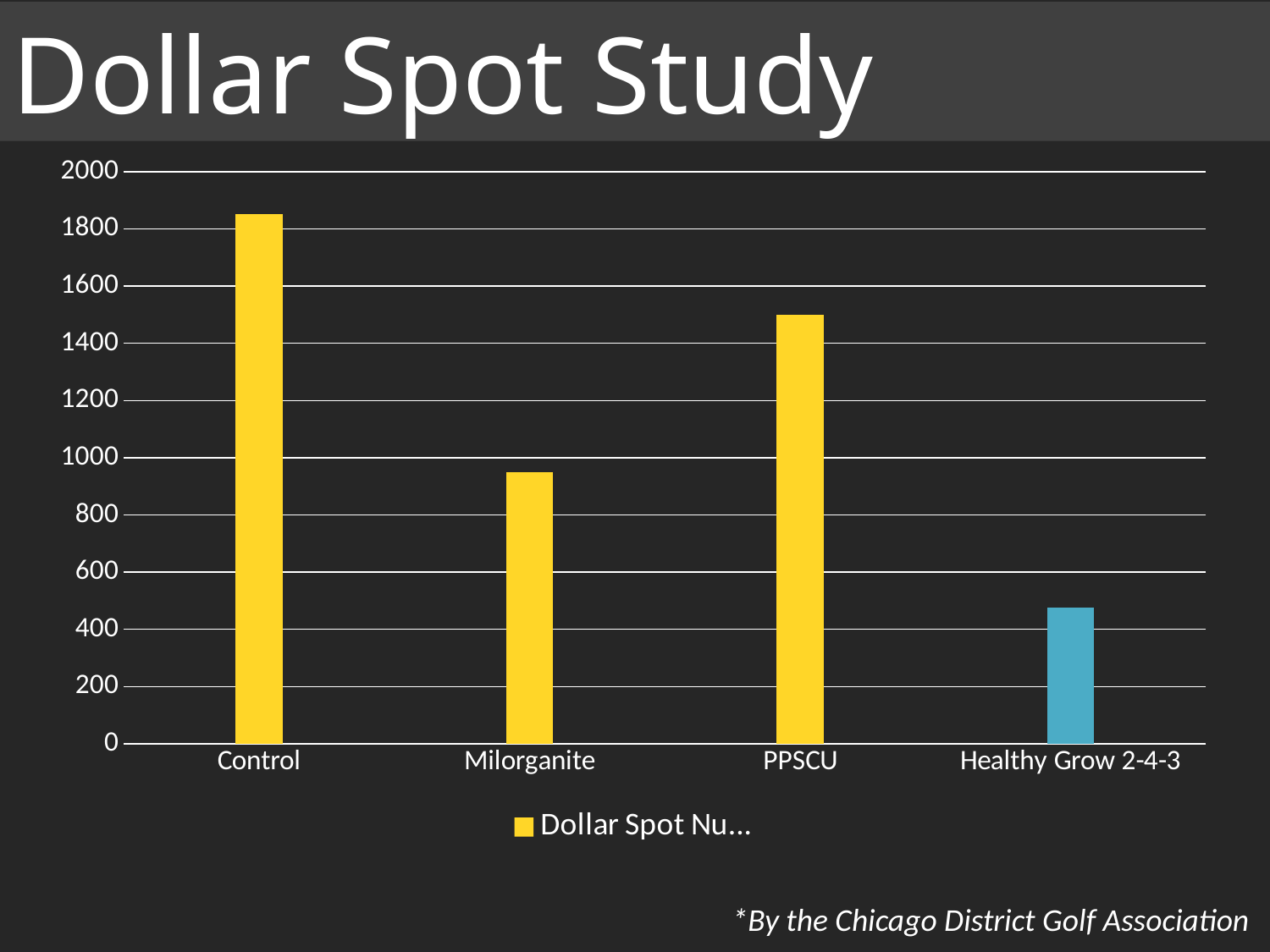
Which category has the highest bar? Control Is the value for Control greater or less than 1800? greater Which bar is shown in a different colour (blue) from the others? Healthy Grow 2-4-3 Which is larger, the value for Milorganite or the value for PPSCU? PPSCU Is the value for Healthy Grow 2-4-3 greater or less than 600? less What kind of chart is shown on the slide? Bar chart How many series does the legend list? 1 Is the value for PPSCU greater or less than 1400? greater Which is larger, the value for Healthy Grow 2-4-3 or the value for Milorganite? Milorganite Which category has the lowest bar? Healthy Grow 2-4-3 How many categories are shown on the x axis? 4